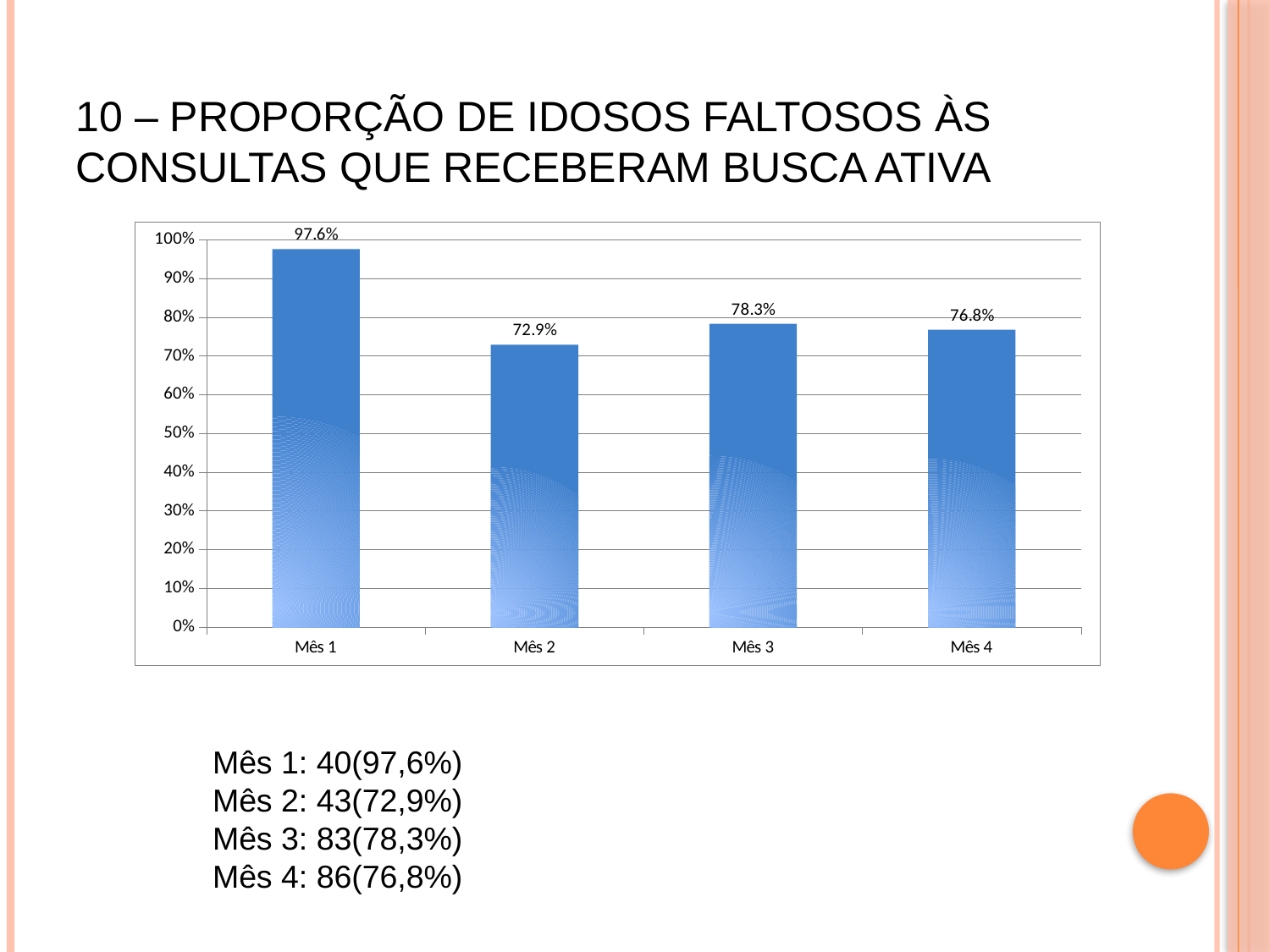
How many months are shown on the x axis? 4 Which month has the highest value? Mês 1 What kind of chart is shown on the slide? bar chart What is the value for Mês 1? 97.6% What is the value for Mês 2? 72.9% What is the difference between the values for Mês 1 and Mês 2? 24.7% What is the value for Mês 3? 78.3% What is the value for Mês 4? 76.8% Which is larger, the value for Mês 3 or the value for Mês 2? Mês 3 What is the difference between the values for Mês 3 and Mês 4? 1.5% Which month has the lowest value? Mês 2 Is the value for Mês 4 greater or less than 80%? less